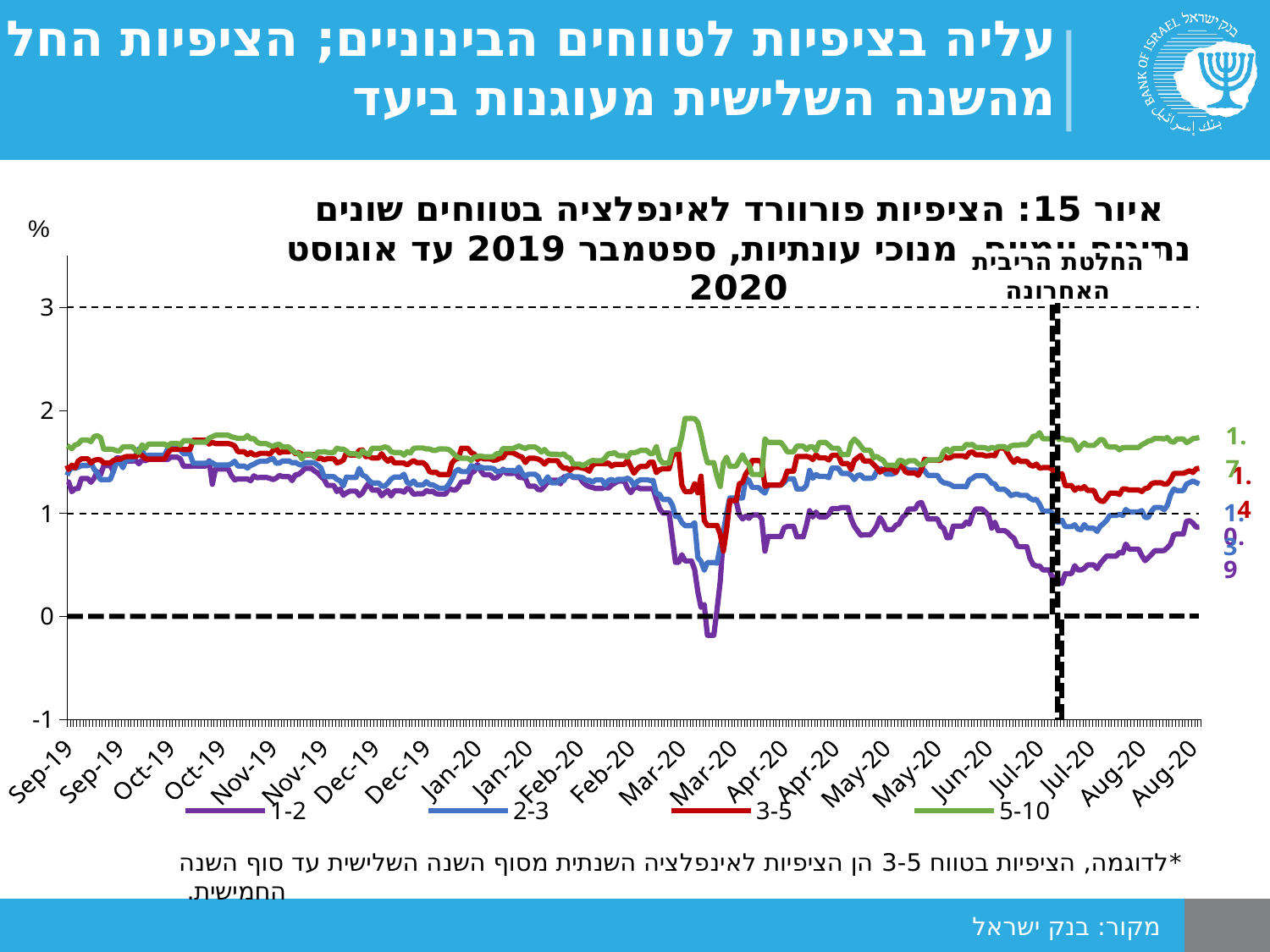
Which series has the highest value at the end of the period (Aug-20)? 5-10 Does the 1-2 series rise or fall between mid Jul-20 and Aug-20? rise Is the lowest point of the 1-2 series (around Mar-20) greater or less than 0? less What is the label on the vertical dashed line near Jul-20? החלטת הריבית האחרונה Is the value of the 1-2 series in mid Jul-20 greater or less than 1? less What are the four series listed in the legend? 1-2, 2-3, 3-5, 5-10 Which series has the lowest value at the end of the period (Aug-20)? 1-2 Which series is the highest throughout the whole period? 5-10 At Aug-20, which is larger: the 5-10 series or the 1-2 series? 5-10 Is the value of the 5-10 series at Aug-20 greater or less than 1? greater What type of chart is shown on the slide? line chart How many series does the legend list? 4